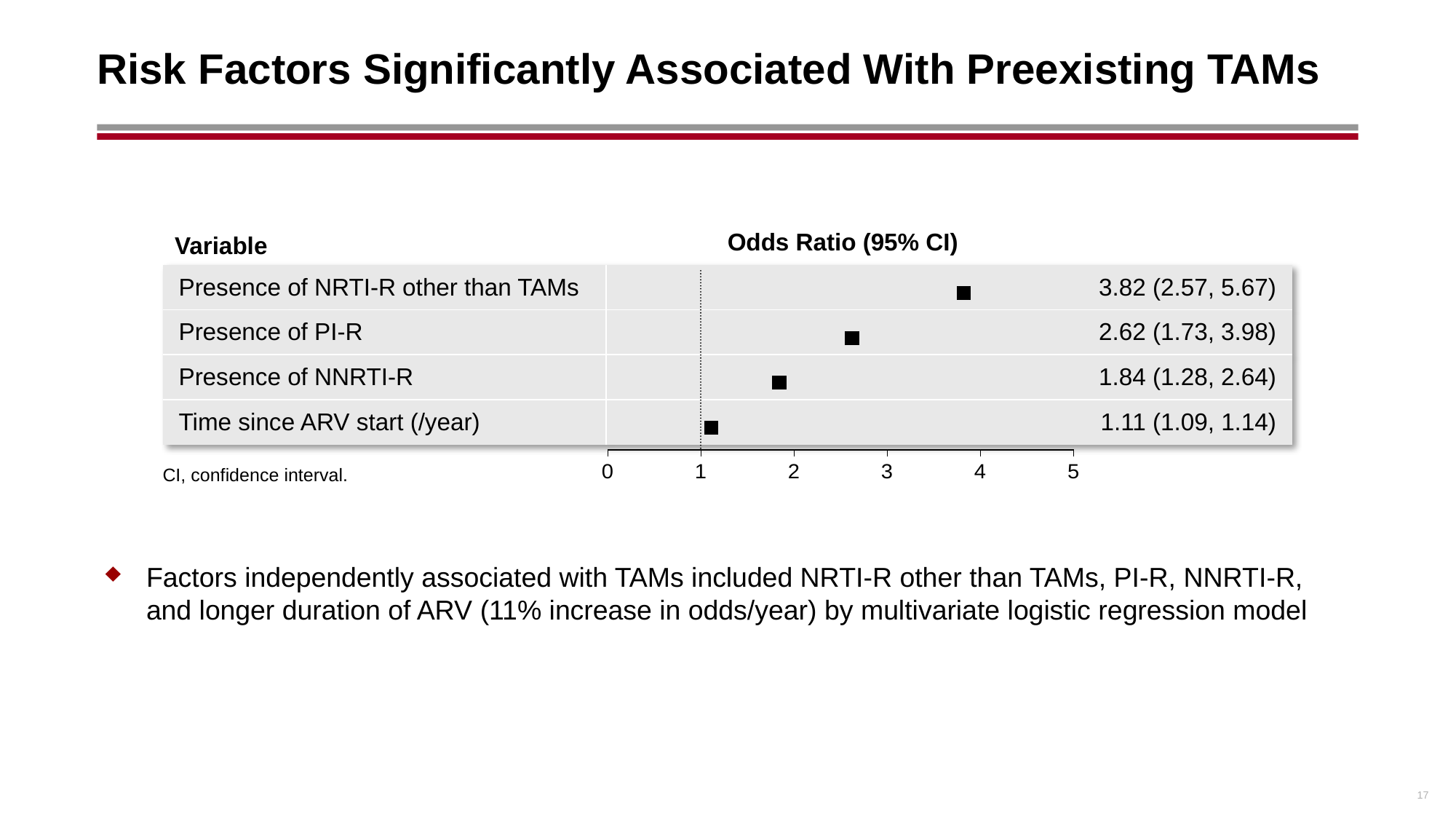
What is the odds ratio for Presence of PI-R? 2.62 What is the 95% confidence interval for Presence of PI-R? (1.73, 3.98) Which variable has the highest odds ratio? Presence of NRTI-R other than TAMs What is the odds ratio for Presence of NRTI-R other than TAMs? 3.82 What is the odds ratio for Time since ARV start (/year)? 1.11 How many variables are plotted in the chart? 4 Which variable has the lowest odds ratio? Time since ARV start (/year) What is the title of the chart's value axis? Odds Ratio (95% CI) Is the odds ratio for Presence of NRTI-R other than TAMs greater or less than 3? greater What is the difference between the odds ratios for Presence of NRTI-R other than TAMs and Presence of PI-R? 1.20 What is the odds ratio for Presence of NNRTI-R? 1.84 Which has a larger odds ratio, Presence of NNRTI-R or Presence of PI-R? Presence of PI-R